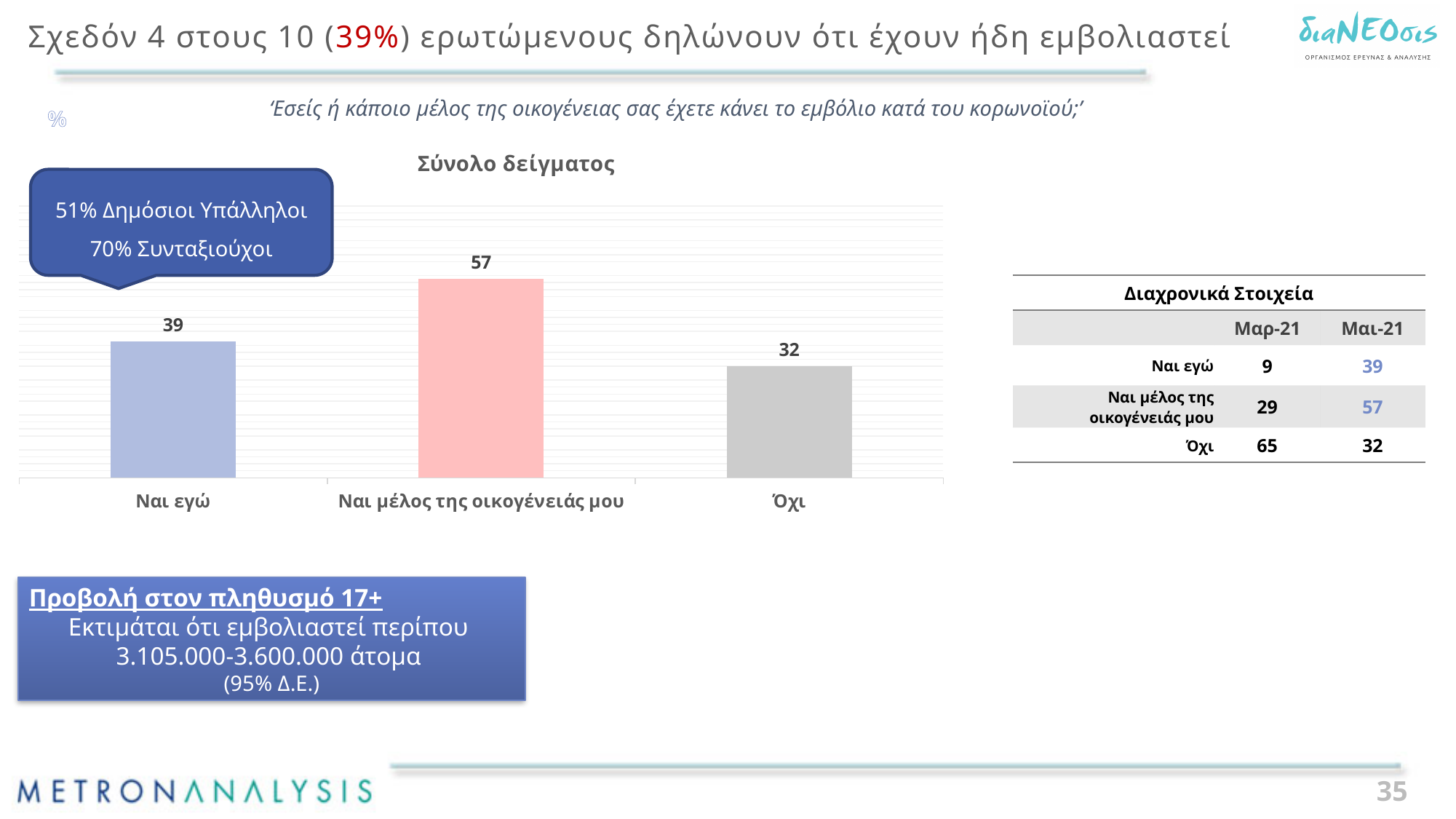
What is the value for "Ναι εγώ" in the chart? 39 What kind of chart is shown on the slide? Bar chart What is the title of the chart? Σύνολο δείγματος What is the value for "Όχι" in the chart? 32 What is the value for "Ναι μέλος της οικογένειάς μου" in the chart? 57 What colour is the bar for "Ναι μέλος της οικογένειάς μου"? Pink Which category has the highest value in the chart? Ναι μέλος της οικογένειάς μου What is the difference between the values for "Ναι μέλος της οικογένειάς μου" and "Ναι εγώ"? 18 Which category has the lowest value in the chart? Όχι Which is larger, the value for "Ναι εγώ" or the value for "Όχι"? Ναι εγώ How many categories are shown in the bar chart? 3 What is the difference between the values for "Ναι εγώ" and "Όχι"? 7